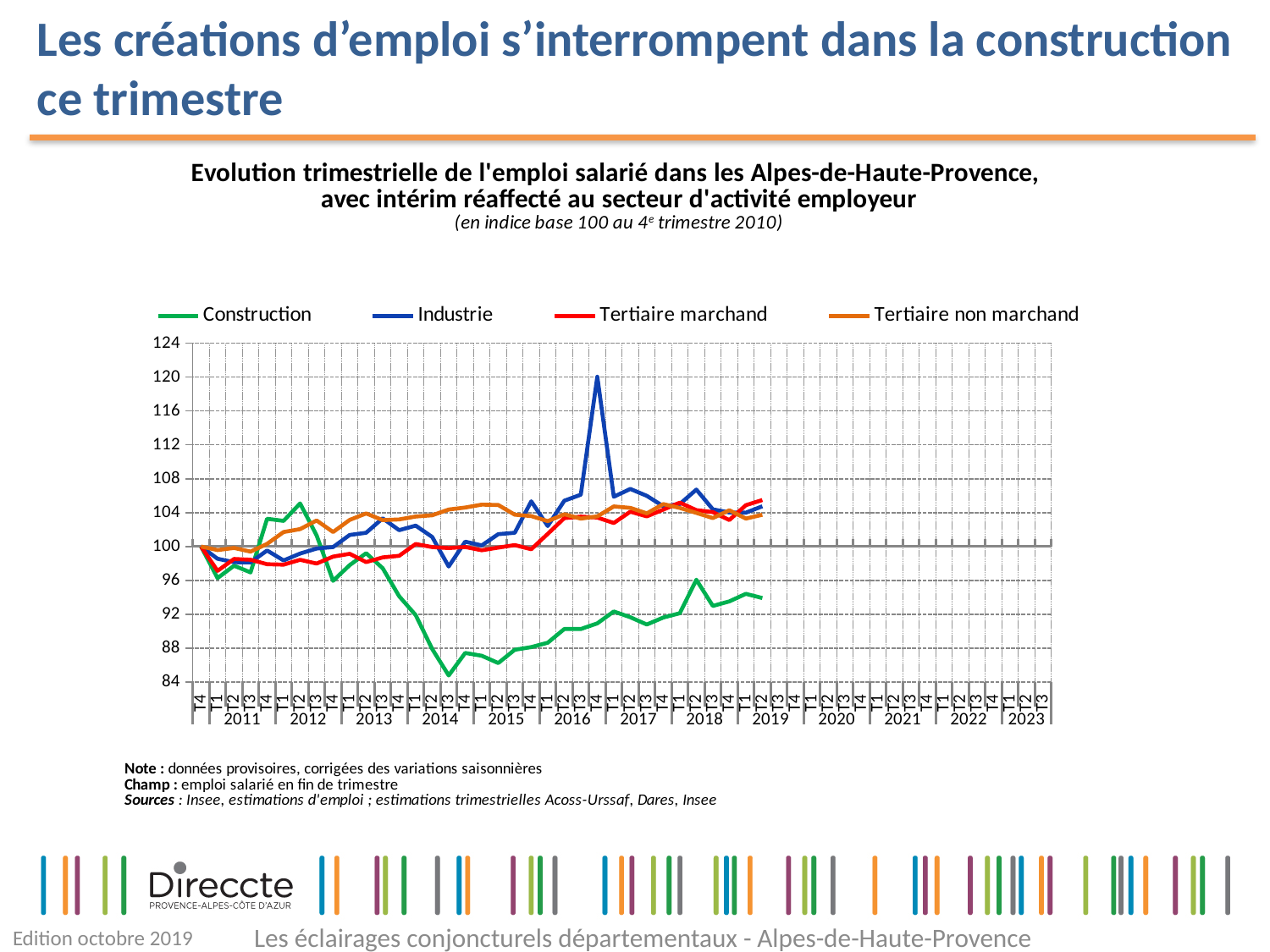
What is the index value of the series at the base period, T4 2010? 100 Is the value for Construction at T2 2019 greater or less than 96? less How many series does the legend list? 4 What colour is the Construction line in the legend? green At T4 2016, which series has the larger value, Industrie or Construction? Industrie What kind of chart is shown on the slide? line chart Does the Construction series rise or fall between T2 2012 and T3 2014? fall Which series reaches the highest value on the chart? Industrie Is the value for Tertiaire non marchand at T1 2016 greater or less than 100? greater Is the value for Construction at T3 2014 greater or less than 88? less Which series falls to the lowest value on the chart? Construction